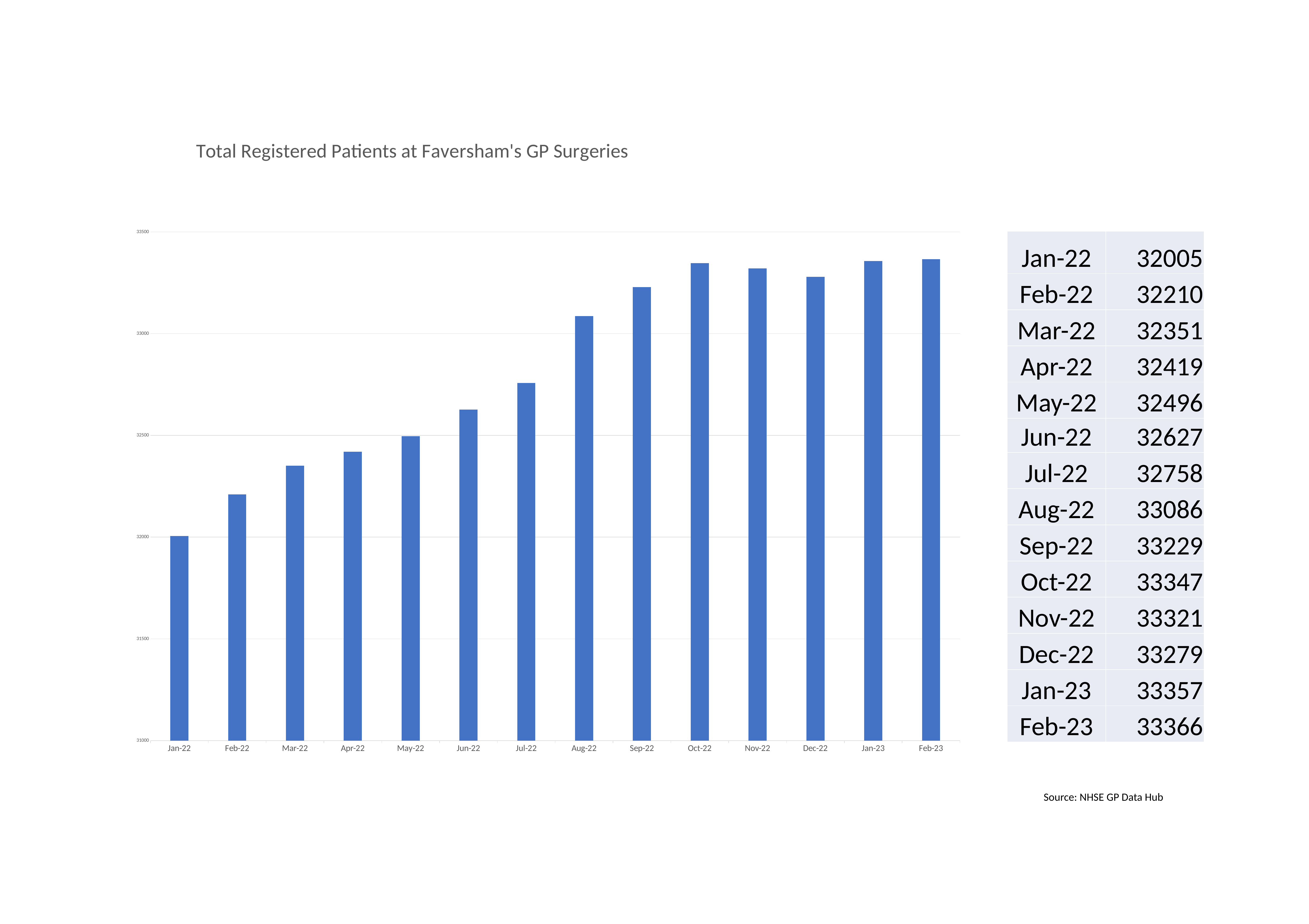
What is the difference between the values for Feb-23 and Jan-22? 1361 Which month has the lowest number of registered patients? Jan-22 What is the difference between the values for Aug-22 and Jul-22? 328 What kind of chart is shown on the slide? bar chart What is the value for Feb-23? 33366 Which month has the highest number of registered patients? Feb-23 Is the value for Jan-22 greater or less than 32500? less Which is larger, the value for Oct-22 or the value for Dec-22? Oct-22 Do the values generally rise or fall from Jan-22 to Feb-23? rise How many months are shown on the chart? 14 What is the value for Jan-22? 32005 What is the value for Aug-22? 33086